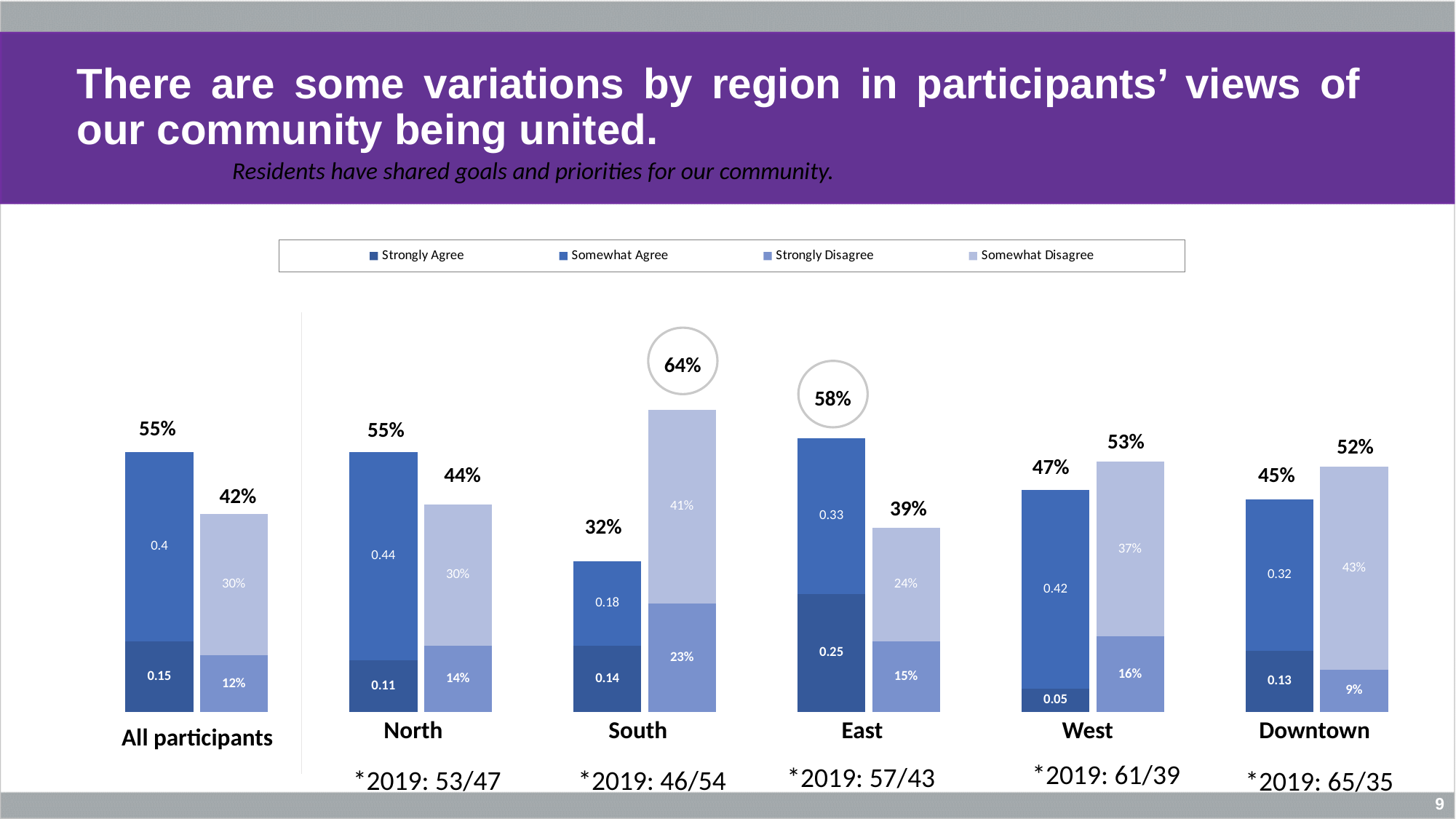
What is the Somewhat Disagree value shown for Downtown? 43% What is the difference between the total agree and total disagree percentages for the East region? 19% What is the Strongly Agree value shown for the East region? 0.25 What is the total agree percentage shown above the agree bar for the South region? 32% Which region has the highest total disagree percentage? South What is the 2019 comparison figure printed below the North region? *2019: 53/47 Which region has the lowest total agree percentage? South Which is larger for the West region, the total agree percentage or the total disagree percentage? Total disagree (53%) How many series does the legend list? 4 How many regions, including All participants, are shown on the chart? 6 What is the Strongly Agree value shown for the West region? 0.05 What kind of chart is shown on the slide? Stacked bar chart